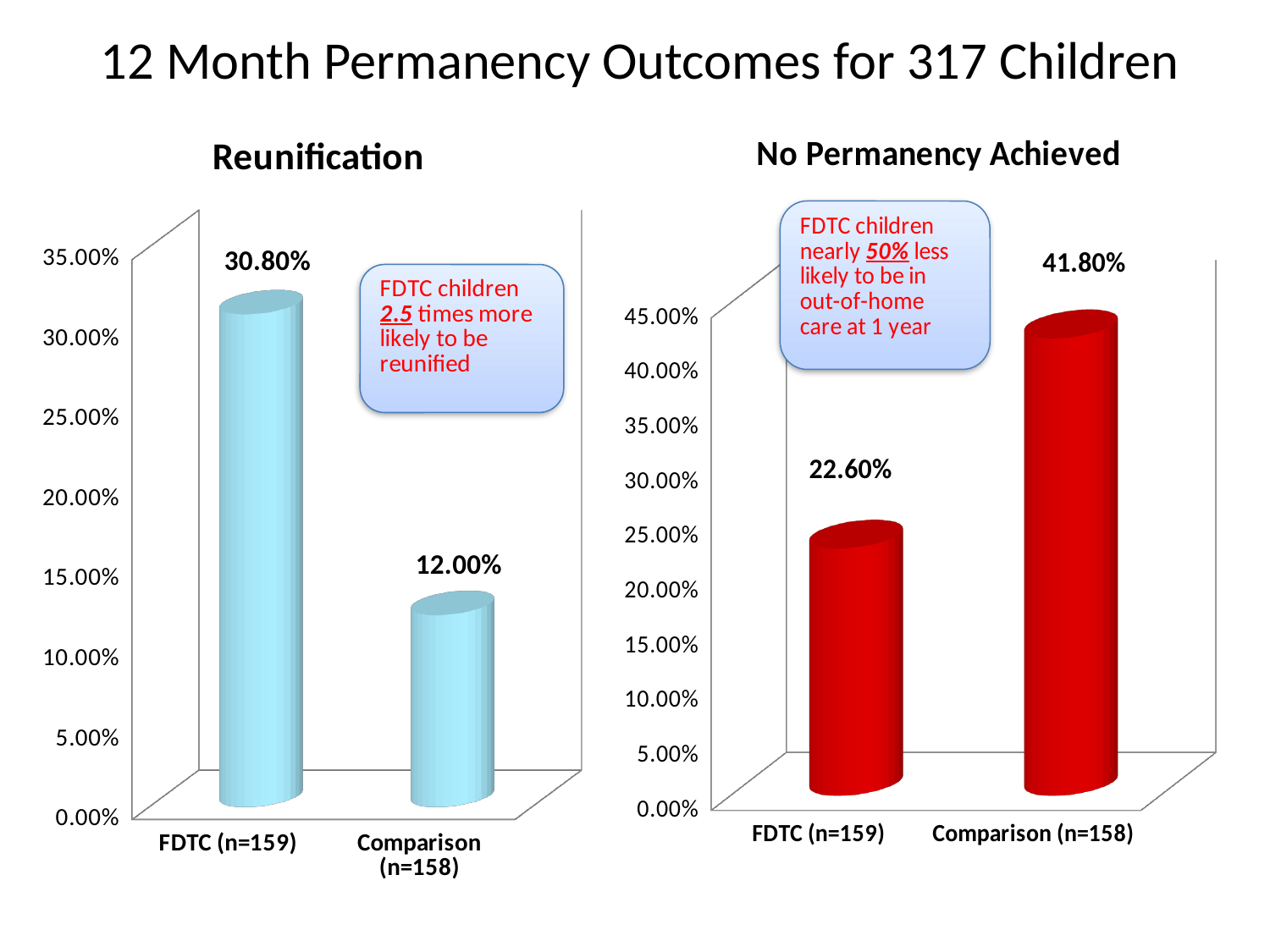
In the No Permanency Achieved chart, what is the value for Comparison (n=158)? 41.80% What kind of chart is the No Permanency Achieved chart? Bar chart In the No Permanency Achieved chart, which category has the lowest value? FDTC (n=159) In the No Permanency Achieved chart, which is larger: the value for FDTC (n=159) or Comparison (n=158)? Comparison (n=158) In the Reunification chart, what is the value for Comparison (n=158)? 12.00% How many categories are shown in the Reunification chart? 2 In the No Permanency Achieved chart, what is the difference between the Comparison (n=158) and FDTC (n=159) values? 19.20% What colour are the bars in the No Permanency Achieved chart? Red In the Reunification chart, what is the value for FDTC (n=159)? 30.80% In the Reunification chart, which category has the highest value? FDTC (n=159) In the No Permanency Achieved chart, what is the value for FDTC (n=159)? 22.60% In the Reunification chart, what is the difference between the FDTC (n=159) and Comparison (n=158) values? 18.80%